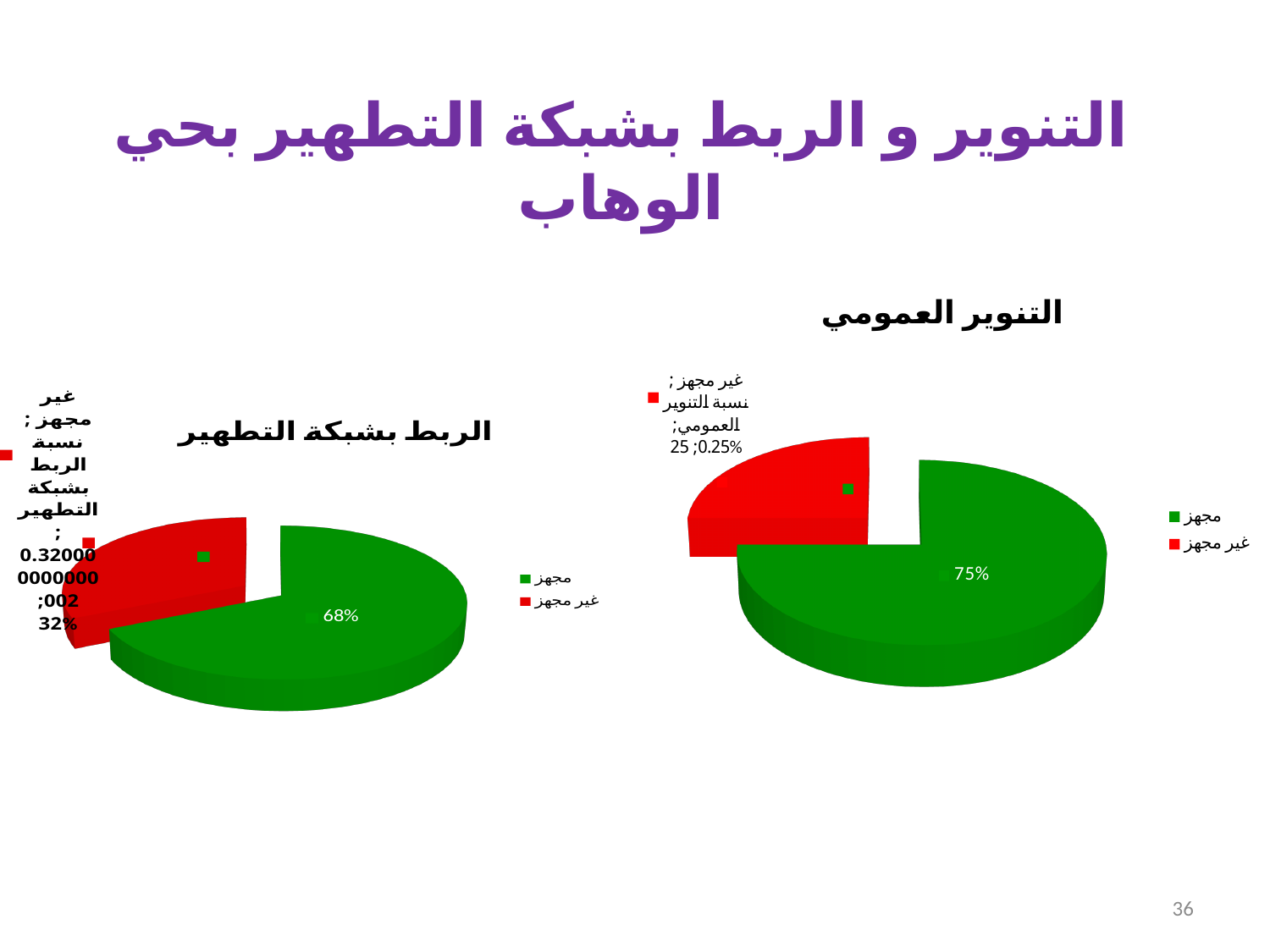
In the "الربط بشبكة التطهير" chart, which category has the smallest slice? غير مجهز In the "الربط بشبكة التطهير" chart, what is the difference between the مجهز and غير مجهز shares? 36% How many slices does the "الربط بشبكة التطهير" chart have? 2 In the "التنوير العمومي" chart, what is the share for مجهز? 75% In the "التنوير العمومي" chart, what colour is the غير مجهز slice? red In the "الربط بشبكة التطهير" chart, what is the share for غير مجهز? 32% What type of chart is the "التنوير العمومي" chart? pie chart Which is larger: the مجهز share in the "التنوير العمومي" chart or the مجهز share in the "الربط بشبكة التطهير" chart? التنوير العمومي In the "التنوير العمومي" chart, which category has the largest slice? مجهز In the "التنوير العمومي" chart, what is the difference between the مجهز and غير مجهز shares? 50% In the "الربط بشبكة التطهير" chart, what is the share for مجهز? 68% In the "التنوير العمومي" chart, what is the share for غير مجهز? 25%